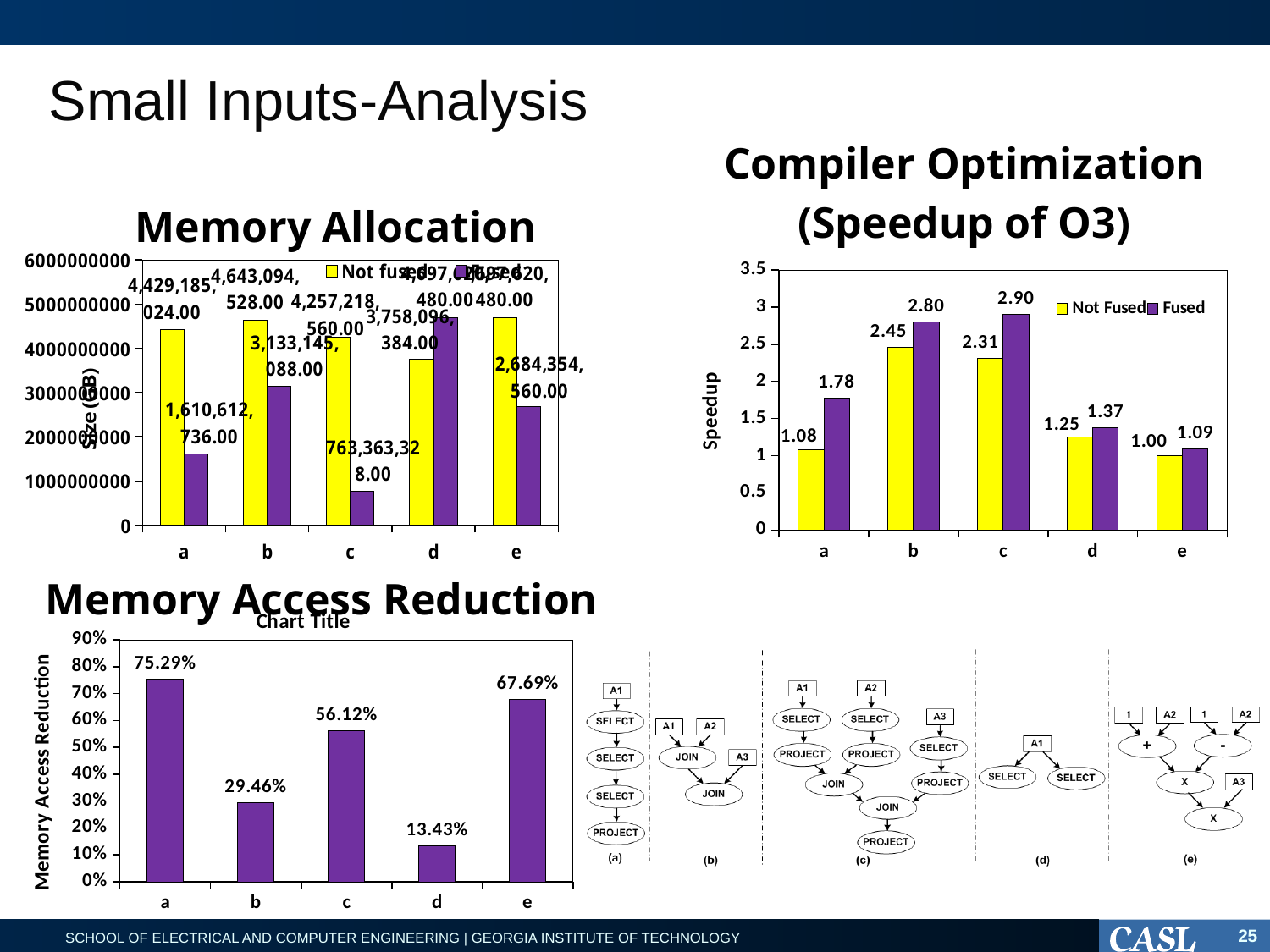
In the Compiler Optimization (Speedup of O3) chart, what is the Fused speedup for category c? 2.90 In the Memory Access Reduction chart, what is the difference between the values for a and e? 7.60% In the Compiler Optimization (Speedup of O3) chart, what is the difference between the Fused and Not Fused speedup for category a? 0.70 In the Memory Access Reduction chart, which category has the lowest memory access reduction? d In the Compiler Optimization (Speedup of O3) chart, which category has the highest Fused speedup? c In the Memory Allocation chart, for category a, which series has the larger value, Not fused or Fused? Not fused In the Memory Allocation chart, how many categories are shown on the x axis? 5 In the Compiler Optimization (Speedup of O3) chart, what is the Not Fused speedup for category b? 2.45 In the Memory Access Reduction chart, which category has the highest memory access reduction? a In the Compiler Optimization (Speedup of O3) chart, how many series does the legend list? 2 In the Memory Access Reduction chart, what is the value for category d? 13.43% In the Memory Access Reduction chart, is the value for c larger than the value for b? Yes, c (56.12%) is larger than b (29.46%)